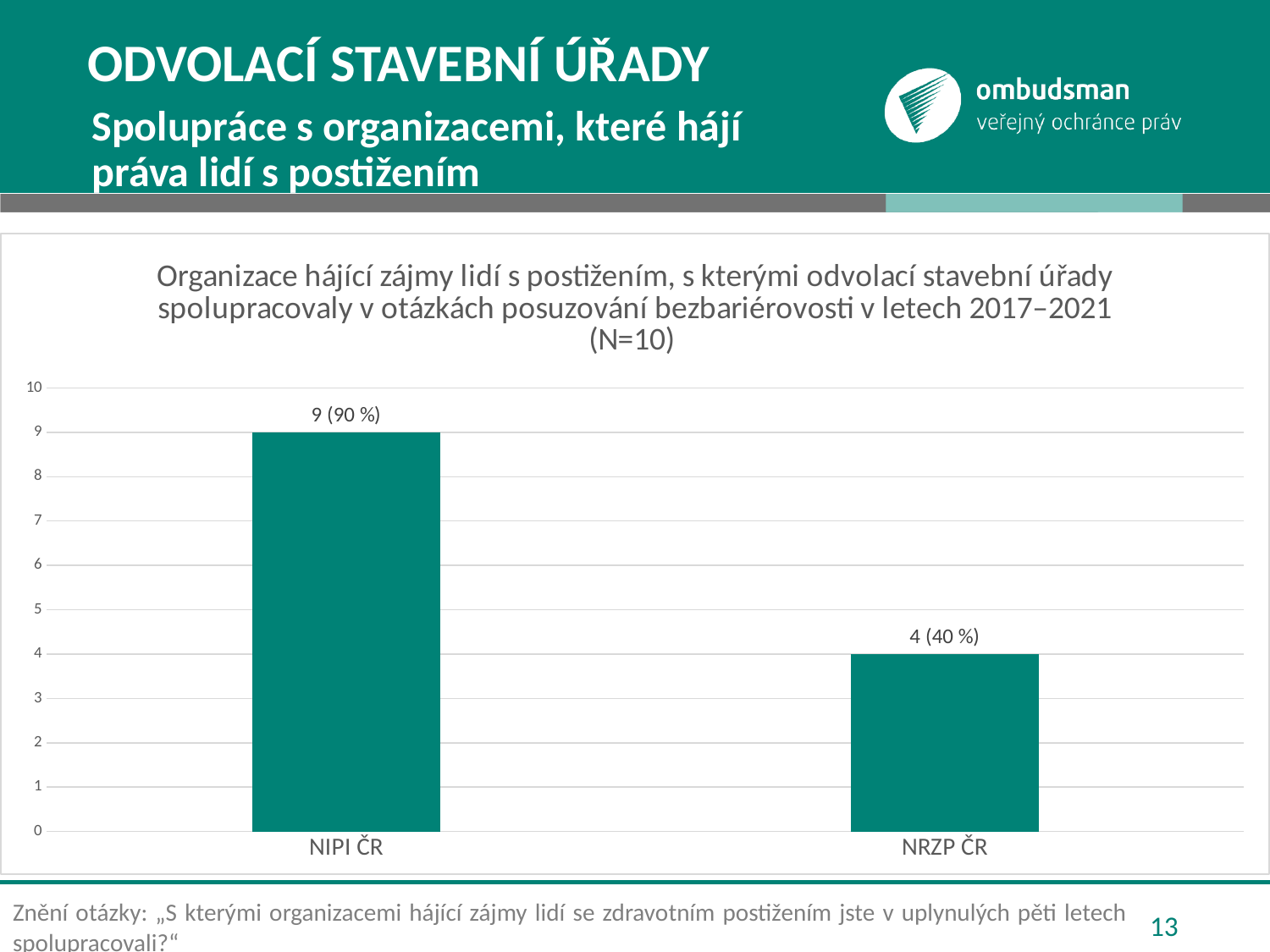
Is the value for NIPI ČR greater or less than 8? greater Is the value for NRZP ČR greater or less than 5? less What is the maximum value shown on the y axis? 10 How many categories are shown on the x axis? 2 Which is larger, the value for NIPI ČR or the value for NRZP ČR? NIPI ČR What kind of chart is shown on the slide? bar chart Which category has the lowest value? NRZP ČR What is the difference between the counts for NIPI ČR and NRZP ČR? 5 What is the N value stated in the chart title? N=10 What is the value shown for NRZP ČR? 4 (40 %) What is the value shown for NIPI ČR? 9 (90 %) Which category has the highest value? NIPI ČR